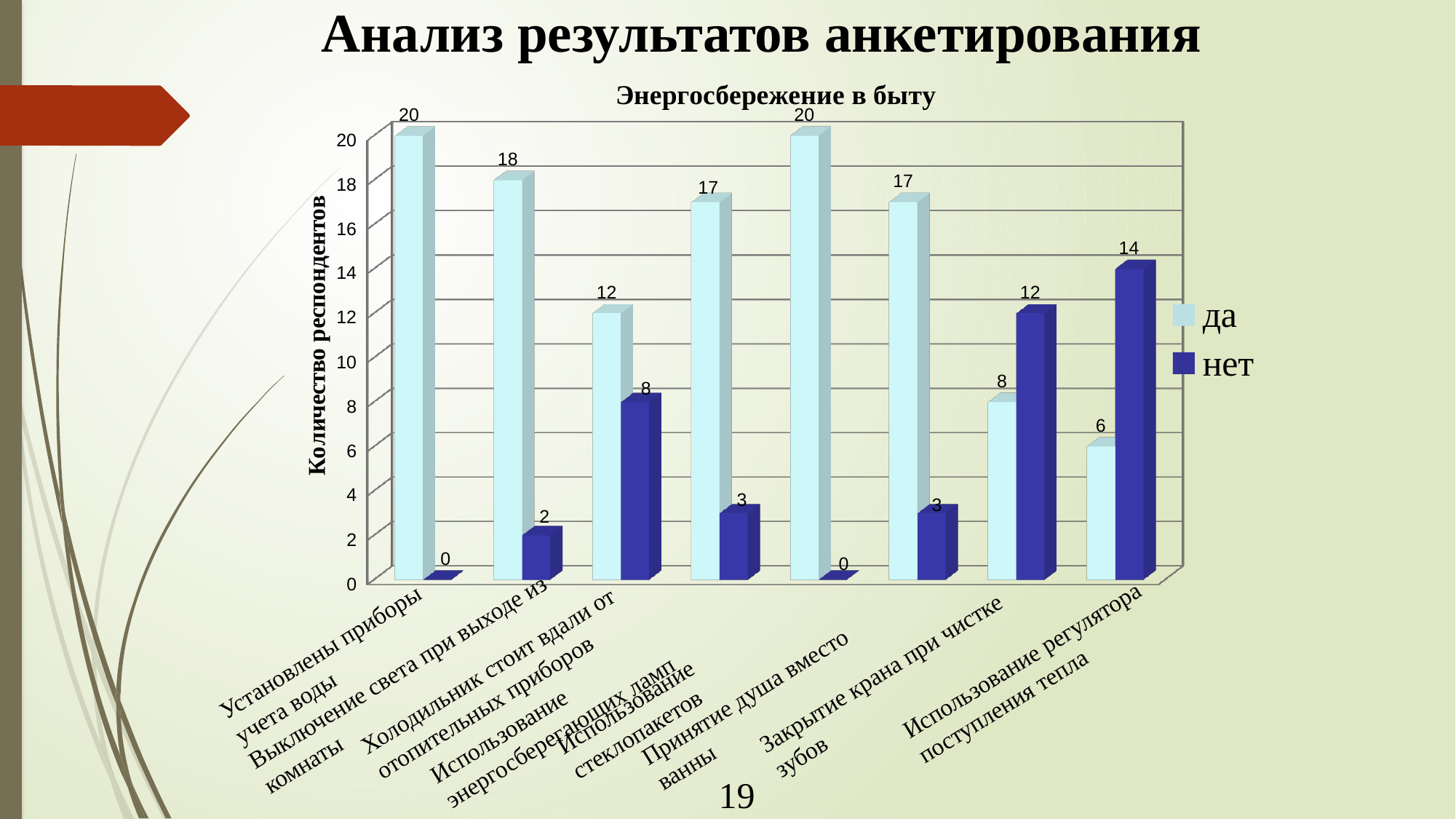
Which category has the lowest value in the "да" series? Использование регулятора поступления тепла What kind of chart is shown on the slide? Bar chart What is the difference between the "да" and "нет" values for "Принятие душа вместо ванны"? 14 Which category has the highest value in the "нет" series? Использование регулятора поступления тепла What is the title of the chart? Энергосбережение в быту For "Закрытие крана при чистке зубов", which is larger: the "да" value or the "нет" value? нет What is the value of the "нет" series for "Холодильник стоит вдали от отопительных приборов"? 8 What is the value of the "да" series for "Выключение света при выходе из комнаты"? 18 How many categories are shown on the x axis? 8 How many series does the legend list? 2 What is the value of the "да" series for "Закрытие крана при чистке зубов"? 8 What is the value of the "нет" series for "Использование стеклопакетов"? 0